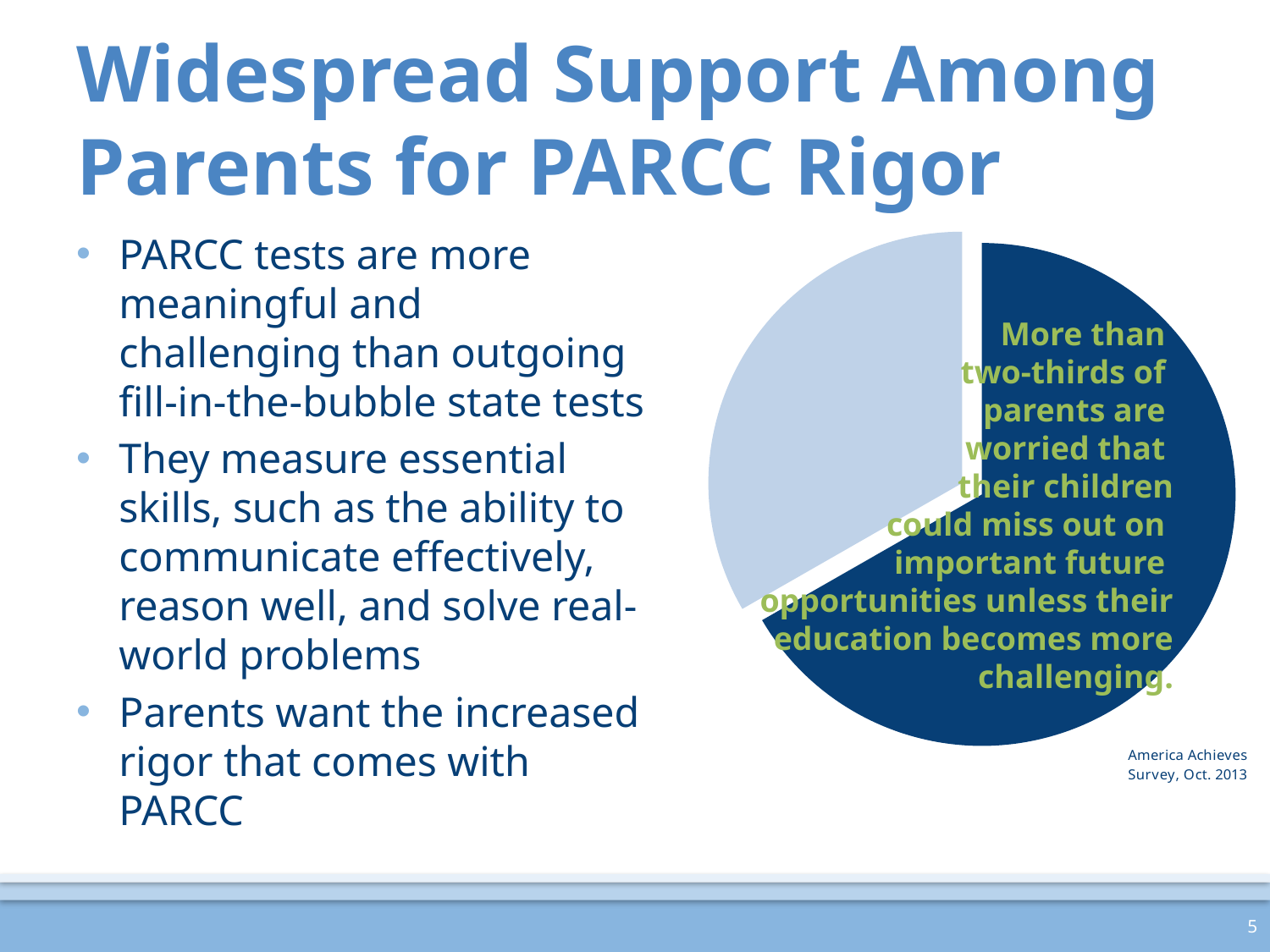
What kind of chart is shown on the slide? pie chart How many slices does the pie chart have? 2 Which slice of the pie chart is larger, the dark blue slice or the light blue slice? the dark blue slice According to the text on the pie chart, what fraction of parents are worried their children could miss out on important future opportunities? More than two-thirds Does the dark blue slice of the pie chart cover more or less than half of the pie? more What source is cited below the pie chart? America Achieves Survey, Oct. 2013 Which slice of the pie chart is the smallest? the light blue slice